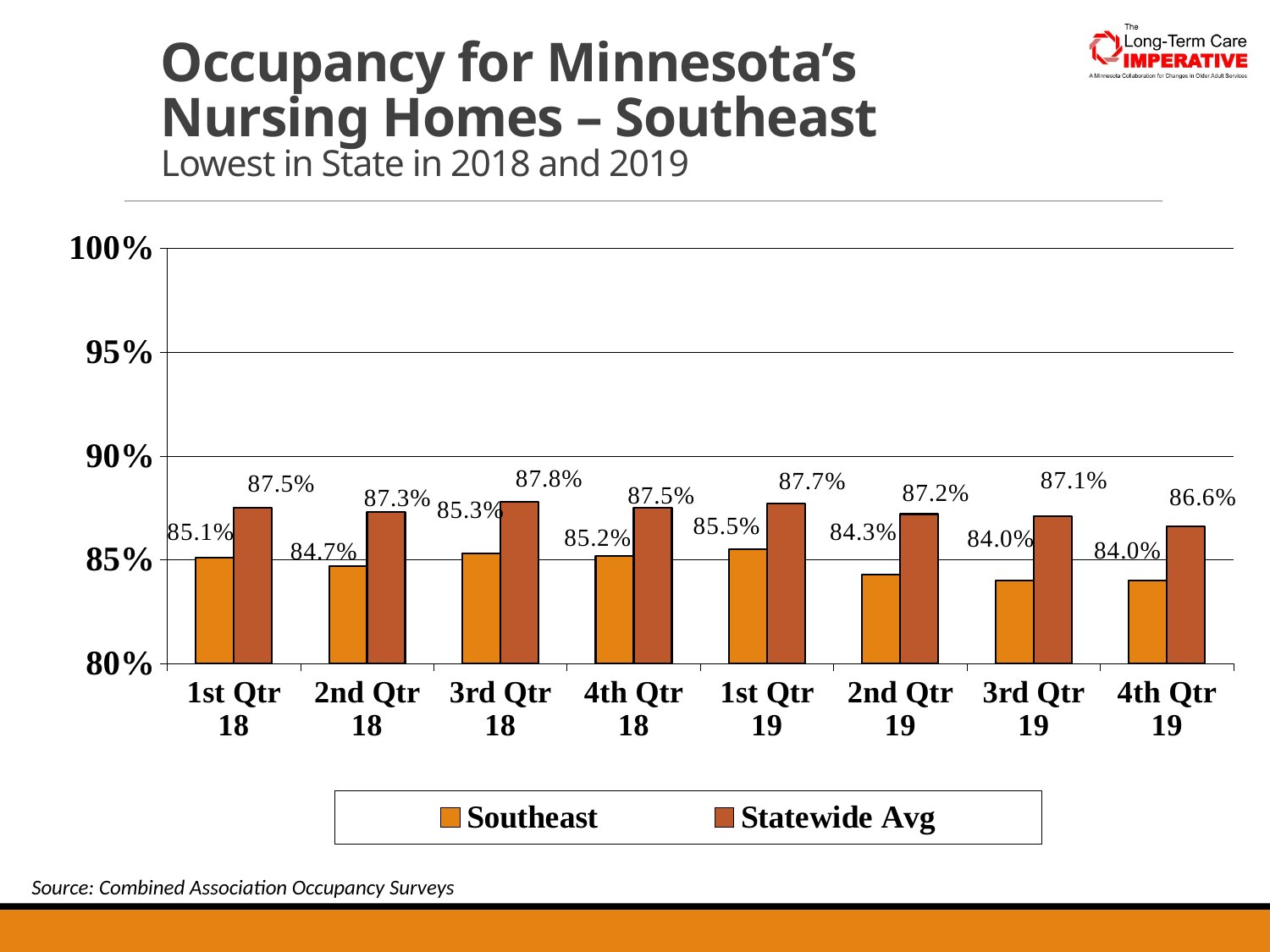
What is the Southeast occupancy value for 1st Qtr 19? 85.5% How many quarters are shown on the x axis? 8 Which is larger: the Southeast value for 1st Qtr 19 or for 2nd Qtr 19? 1st Qtr 19 How many series does the legend list? 2 In which quarter is the Statewide Avg lowest? 4th Qtr 19 In which quarter is the Statewide Avg highest? 3rd Qtr 18 What kind of chart is shown on the slide? Bar chart Is the Southeast value for 2nd Qtr 19 greater or less than 85%? less What is the difference between the Statewide Avg and the Southeast value in 1st Qtr 18? 2.4 percentage points In which quarter is the Southeast value highest? 1st Qtr 19 What is the Southeast value for 2nd Qtr 18? 84.7% What is the Statewide Avg value for 4th Qtr 19? 86.6%